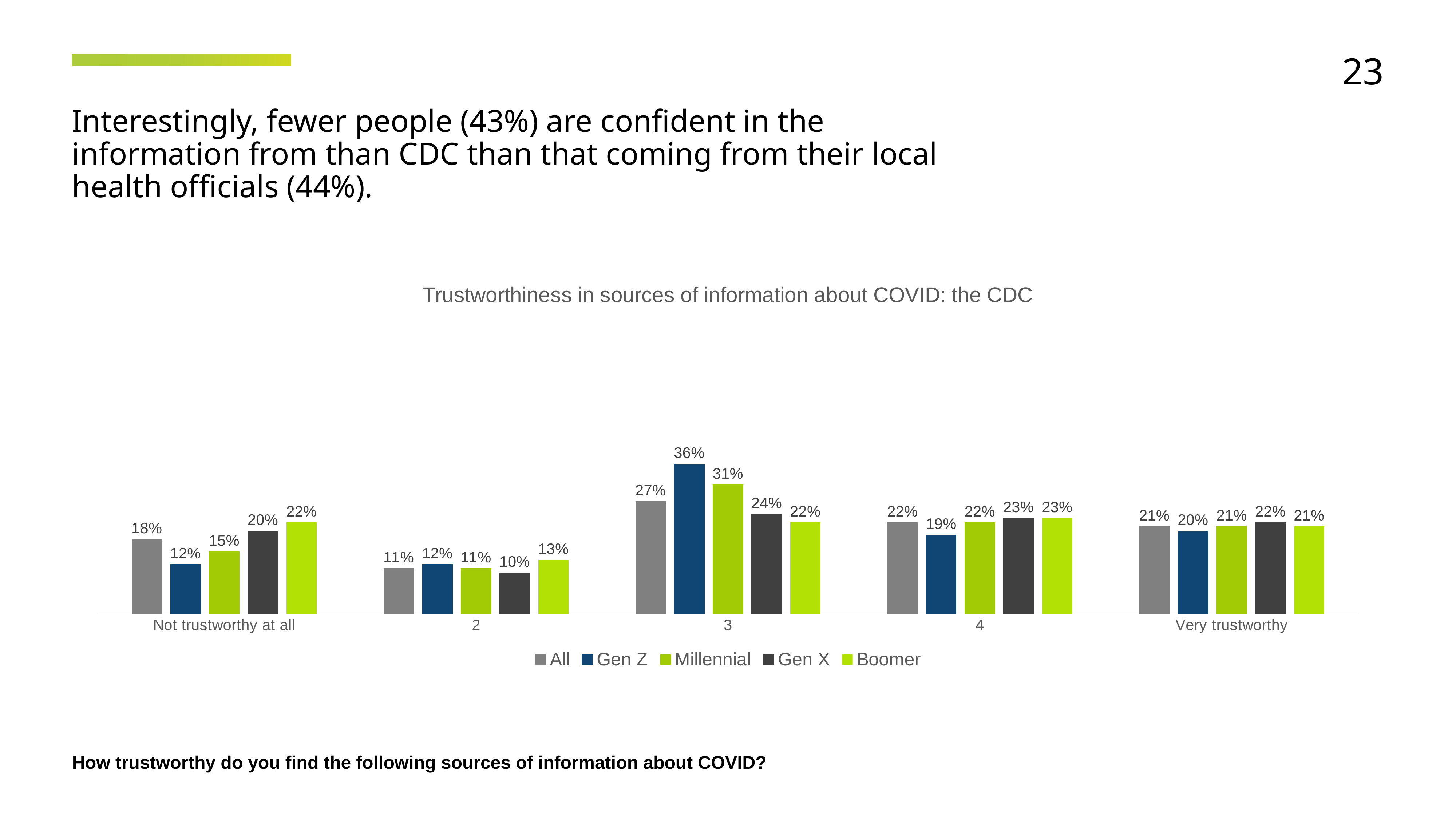
What is the value for Gen Z in the '3' category? 36% What type of chart is shown on the slide? Bar chart Which series has the highest value in the '3' category? Gen Z How many categories are shown along the x axis? 5 What is the value for All in the 'Very trustworthy' category? 21% In the 'Not trustworthy at all' category, which is larger: the value for Gen X or the value for Millennial? Gen X Which series has the lowest value in the 'Not trustworthy at all' category? Gen Z What is the title of the chart? Trustworthiness in sources of information about COVID: the CDC What is the value for Boomer in the 'Not trustworthy at all' category? 22% What is the value for Gen X in the '2' category? 10% What is the difference between the Gen Z and All values in the '3' category? 9% How many series does the legend list? 5